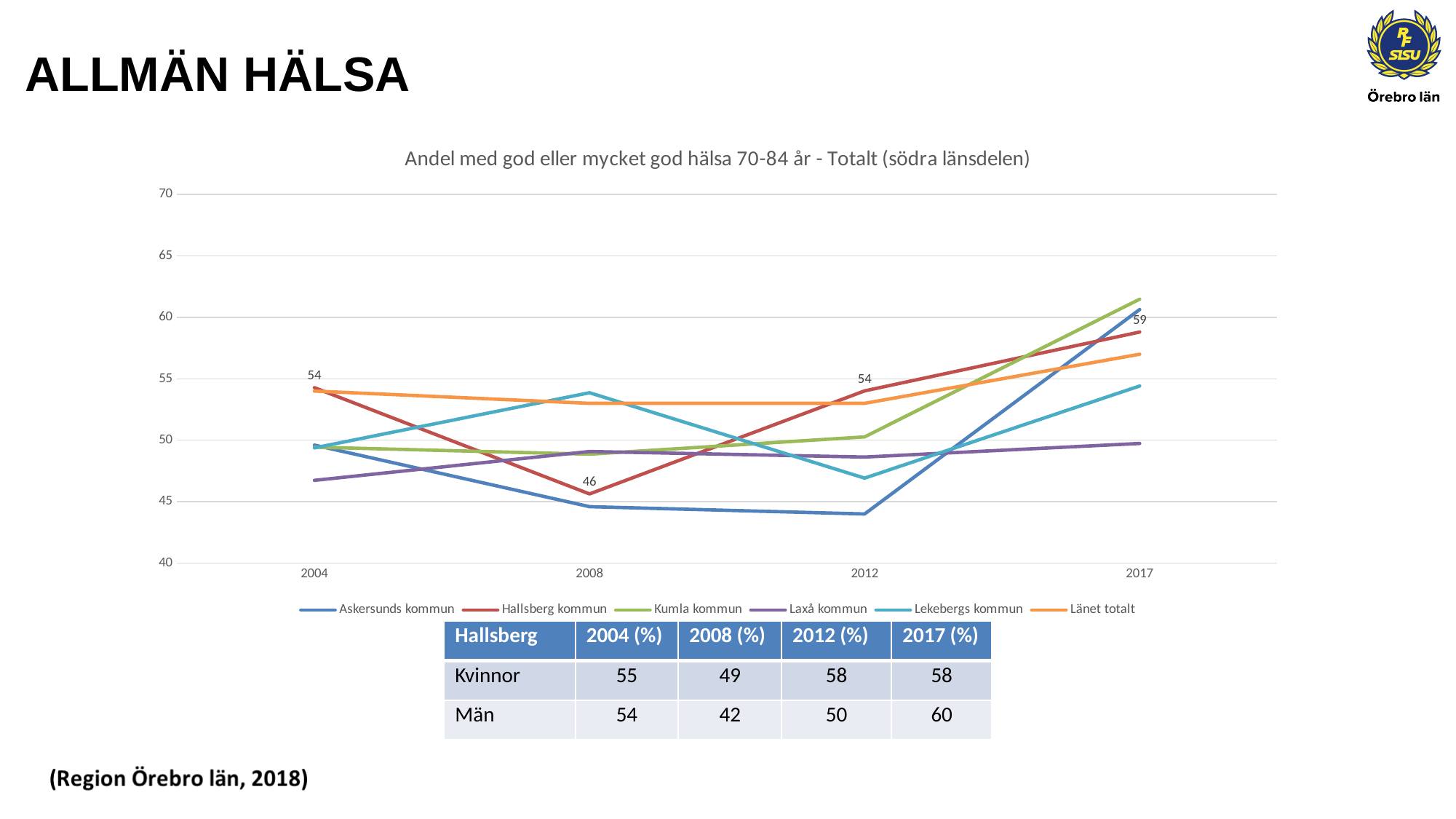
Which series has the lowest value in 2012? Askersunds kommun Is the value for Kumla kommun in 2017 greater or less than 60? greater In which year is the value for Hallsberg kommun lowest? 2008 What kind of chart is shown on the slide? line chart How many series does the chart legend list? 6 What is the difference between the Hallsberg kommun values for 2017 and 2008? 13 How many years are plotted along the x axis of the chart? 4 What is the value for Hallsberg kommun in 2017? 59 Is the value for Askersunds kommun in 2012 greater or less than 45? less What is the value for Hallsberg kommun in 2004? 54 What is the value for Hallsberg kommun in 2008? 46 What is the title of the chart? Andel med god eller mycket god hälsa 70-84 år - Totalt (södra länsdelen)